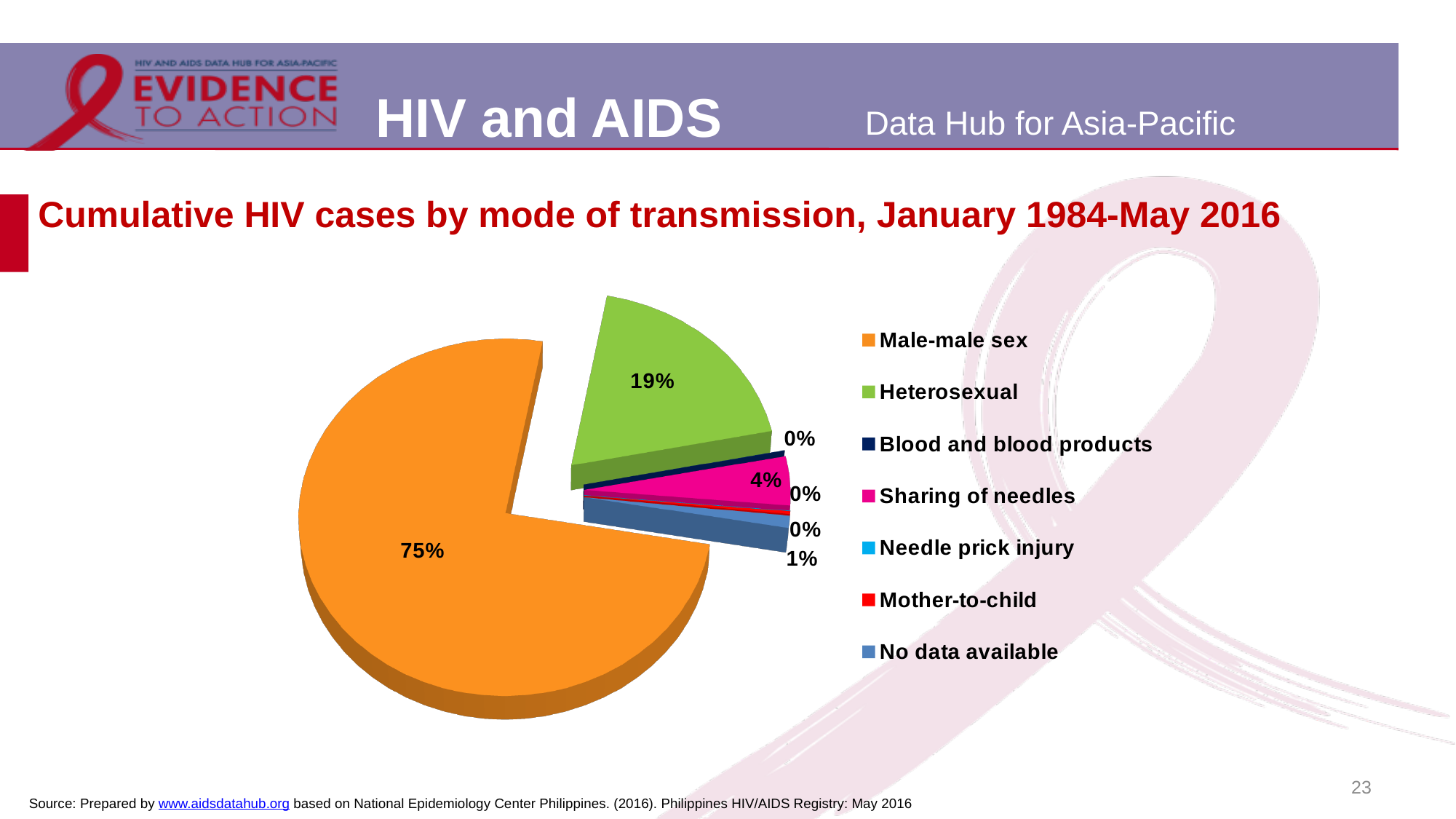
What is the title of the chart? Cumulative HIV cases by mode of transmission, January 1984-May 2016 How many modes of transmission are listed in the legend? 7 What colour represents the 'Sharing of needles' slice in the pie chart? Magenta (pink) Which is larger: the share for heterosexual transmission or the share for sharing of needles? Heterosexual What share of cumulative HIV cases falls under 'No data available'? 1% What is the combined share of male-male sex and heterosexual transmission? 94% What is the difference in percentage points between the male-male sex share and the heterosexual share? 56 What share of cumulative HIV cases is attributed to male-male sex? 75% What type of chart is shown on the slide? Pie chart What share of cumulative HIV cases is attributed to heterosexual transmission? 19% Which mode of transmission accounts for the largest share of cumulative HIV cases? Male-male sex What share of cumulative HIV cases is attributed to sharing of needles? 4%